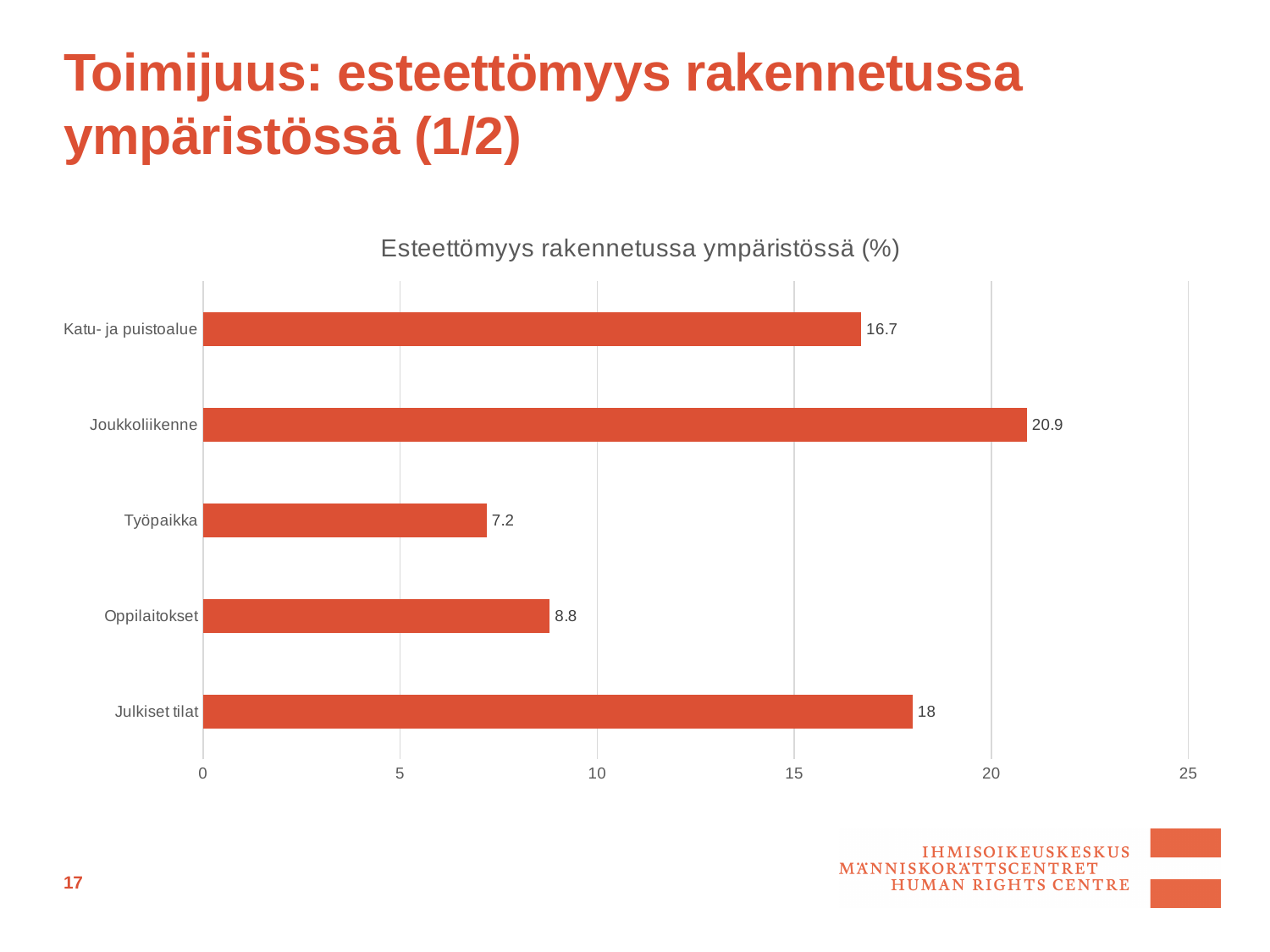
What is the title of the chart? Esteettömyys rakennetussa ympäristössä (%) Which category has the lowest value? Työpaikka How many categories are shown in the chart? 5 Which is larger, the value for Julkiset tilat or the value for Katu- ja puistoalue? Julkiset tilat What is the value for Joukkoliikenne? 20.9 What is the difference between the values for Joukkoliikenne and Katu- ja puistoalue? 4.2 What is the value for Julkiset tilat? 18 What is the difference between the values for Oppilaitokset and Työpaikka? 1.6 Which category has the highest value? Joukkoliikenne What is the value for Työpaikka? 7.2 Is the value for Oppilaitokset greater or less than 10? less What kind of chart is shown on the slide? bar chart